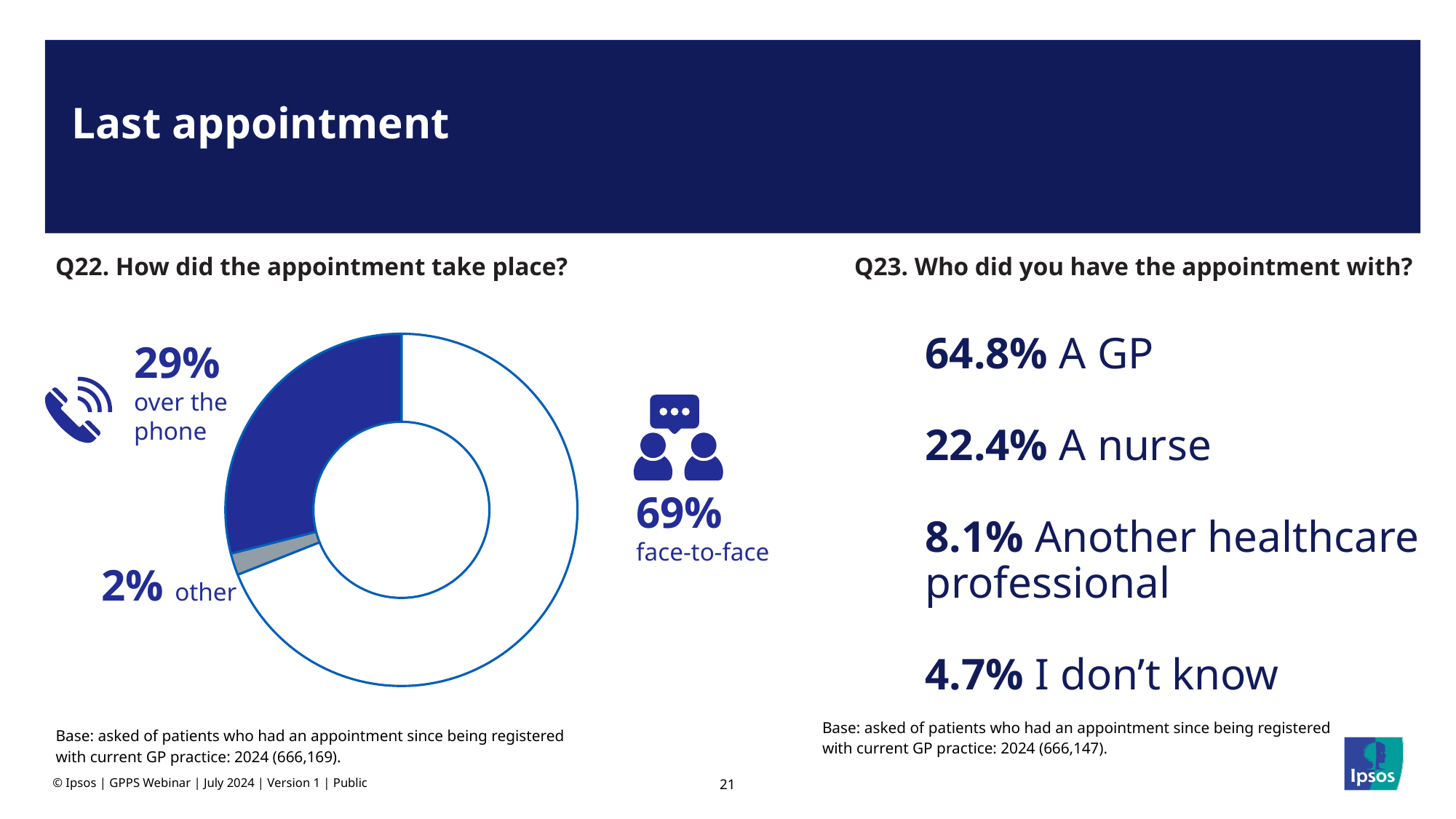
In the Q22 chart, which category has the largest share? face-to-face In the Q22 chart, which category is shown as the white (unfilled) segment? face-to-face In the Q22 chart, what is the combined share of over the phone and other? 31% In the Q22 chart, what share of appointments took place over the phone? 29% What kind of chart is used for Q22 'How did the appointment take place?' Donut (pie) chart In the Q22 chart, which category has the smallest share? other In the Q22 chart, which is larger: the share over the phone or the share for other? over the phone How many categories does the Q22 donut chart show? 3 In the Q22 chart, what share of appointments is labelled 'other'? 2% In the Q22 chart, what share of appointments took place face-to-face? 69% In the Q22 chart, how many percentage points higher is face-to-face than over the phone? 40 In the Q22 chart, which category is shown in grey? other